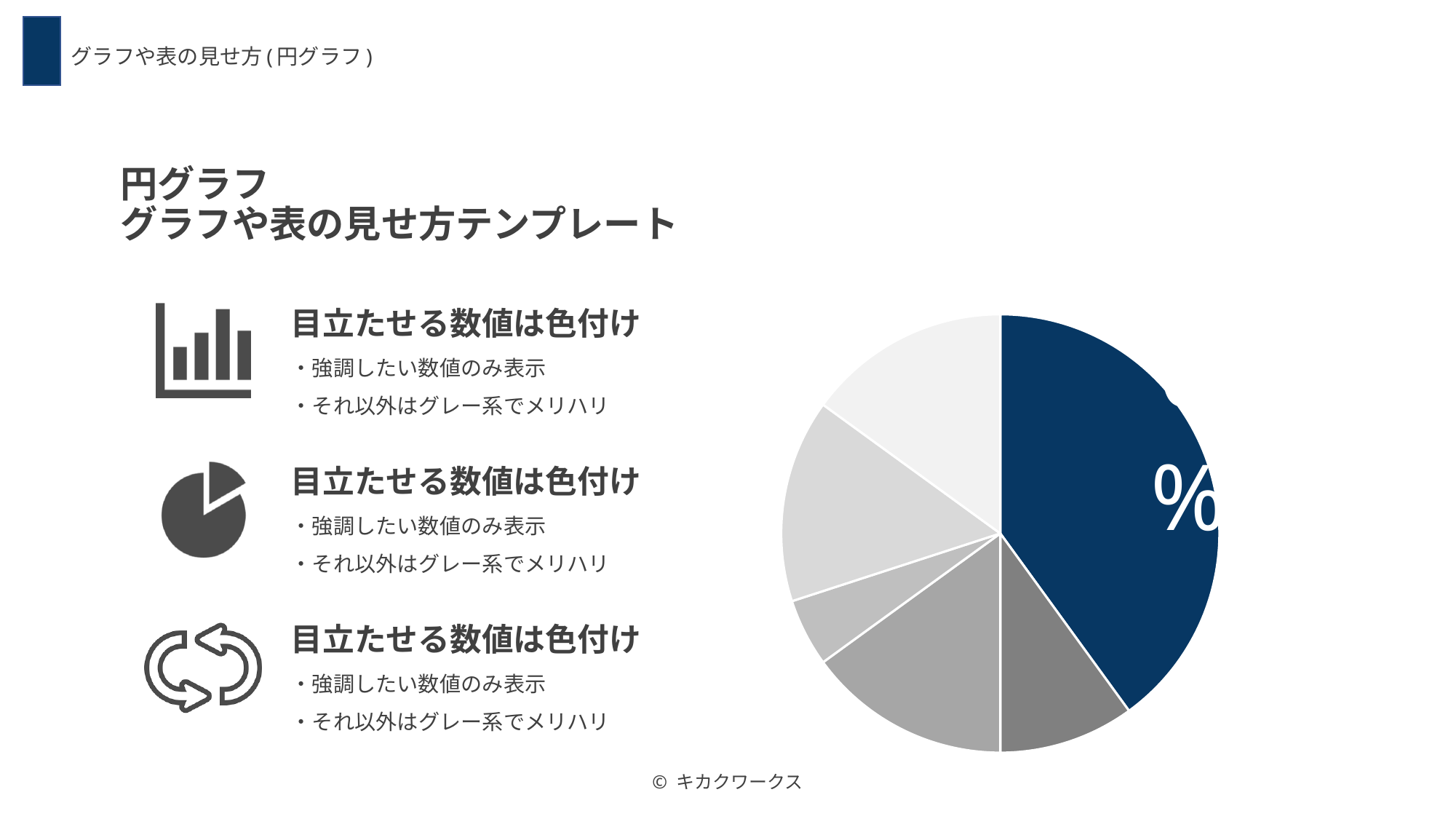
How many slices does the pie chart have? 6 Apart from the highlighted slice, what colour family are the other slices of the pie chart? grey Which slice of the pie chart is the largest? the dark blue slice What colour is the highlighted (emphasised) slice of the pie chart? dark blue What kind of chart is shown on the right side of the slide? pie chart